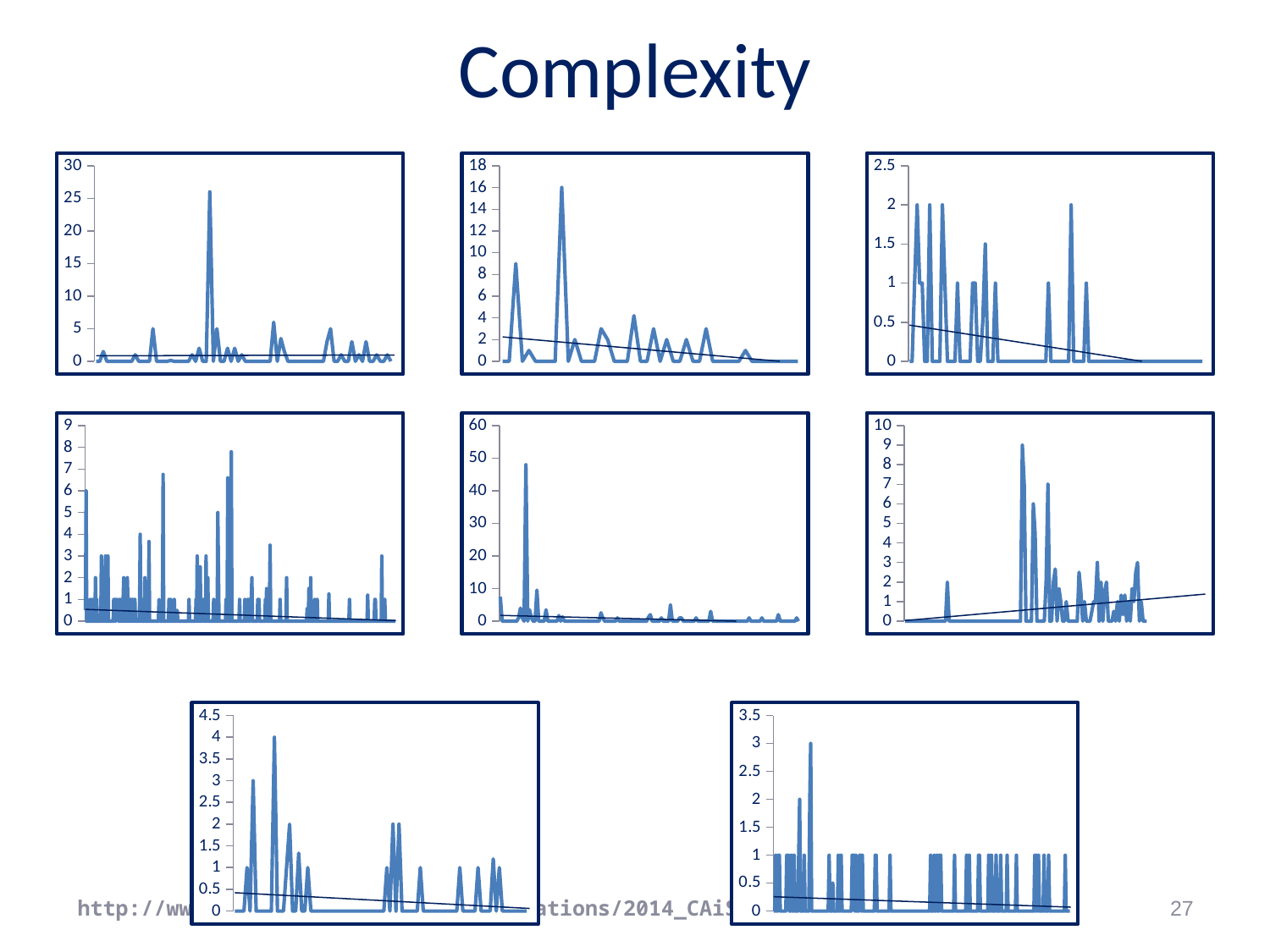
In the top-left chart, is the highest peak greater or less than 20? greater In the middle-row right chart, does the straight trend line rise or fall from left to right? rises In the middle-row center chart (y axis up to 60), is the highest peak greater or less than 40? greater In the top-middle chart, what value does the highest peak reach? 16 What kind of chart is the top-left chart on the slide? line chart In the bottom-right chart, what is the maximum value the line reaches? 3 In the middle-row left chart, is the highest peak greater or less than 7? greater How many charts are shown on the slide? 8 In the top-right chart, what is the maximum value the line reaches? 2 In the top-middle chart, does the straight trend line rise or fall from left to right? falls In the middle-row right chart, what value does the highest peak reach? 9 In the bottom-left chart, what is the maximum value the line reaches? 4